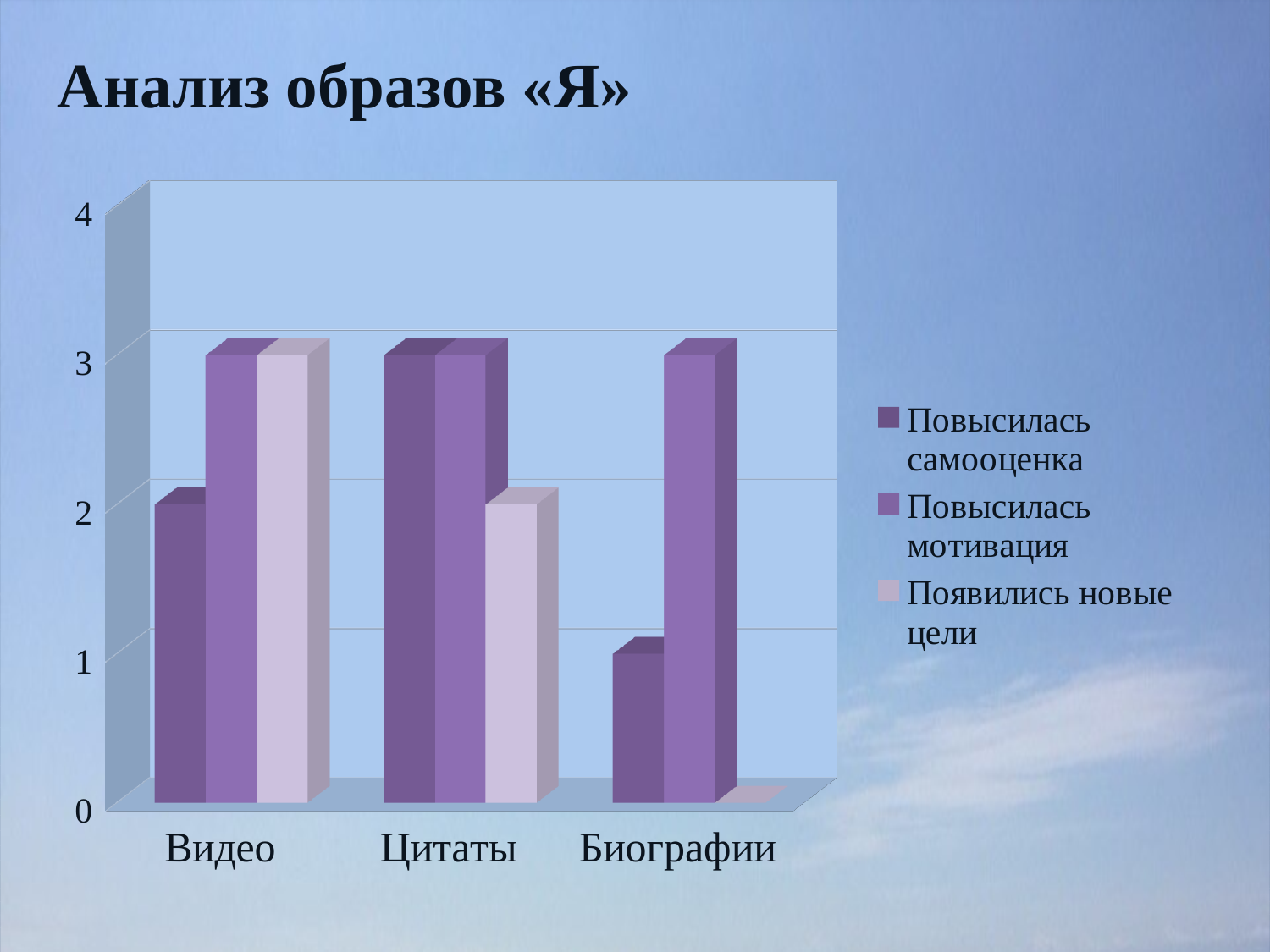
How many series does the chart's legend list? 3 How many categories are shown on the x axis of the chart? 3 Which category has the highest value in the series Появились новые цели? Видео What is the value for Биографии in the series Появились новые цели? 0 Which is larger: the value for Видео or for Биографии in the series Повысилась самооценка? Видео What is the value for Биографии in the series Повысилась самооценка? 1 What is the difference between the Повысилась мотивация value and the Повысилась самооценка value for Биографии? 2 What is the title of the slide containing the chart? Анализ образов «Я» What is the value for Цитаты in the series Появились новые цели? 2 Which category has the lowest value in the series Повысилась самооценка? Биографии What is the value for Видео in the series Повысилась самооценка? 2 What kind of chart is shown on the slide? bar chart